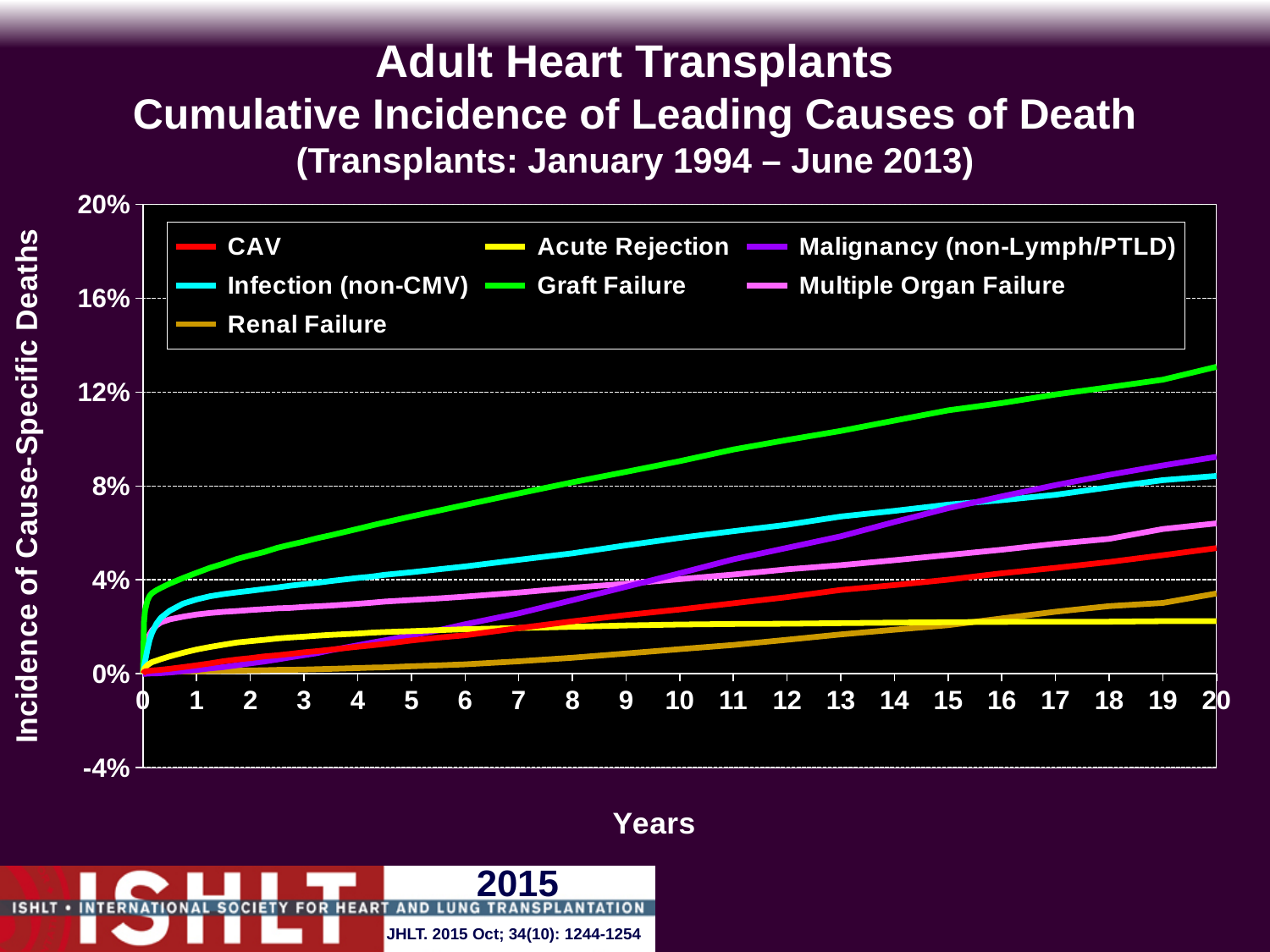
At 20 years, which is larger: the cumulative incidence for Graft Failure or for CAV? Graft Failure Which cause of death has the highest cumulative incidence at 20 years? Graft Failure Which cause of death has the lowest cumulative incidence at 20 years? Acute Rejection Is the value for Graft Failure at 20 years greater or less than 12%? greater How many series does the legend list? 7 What kind of chart is shown on the slide? Line chart Is the value for Infection (non-CMV) at 20 years greater or less than 8%? greater Is the value for Acute Rejection at 20 years greater or less than 4%? less Does the cumulative incidence for Malignancy (non-Lymph/PTLD) rise or fall as years increase? Rise What is the label of the x axis? Years What colour is the Graft Failure line? Green